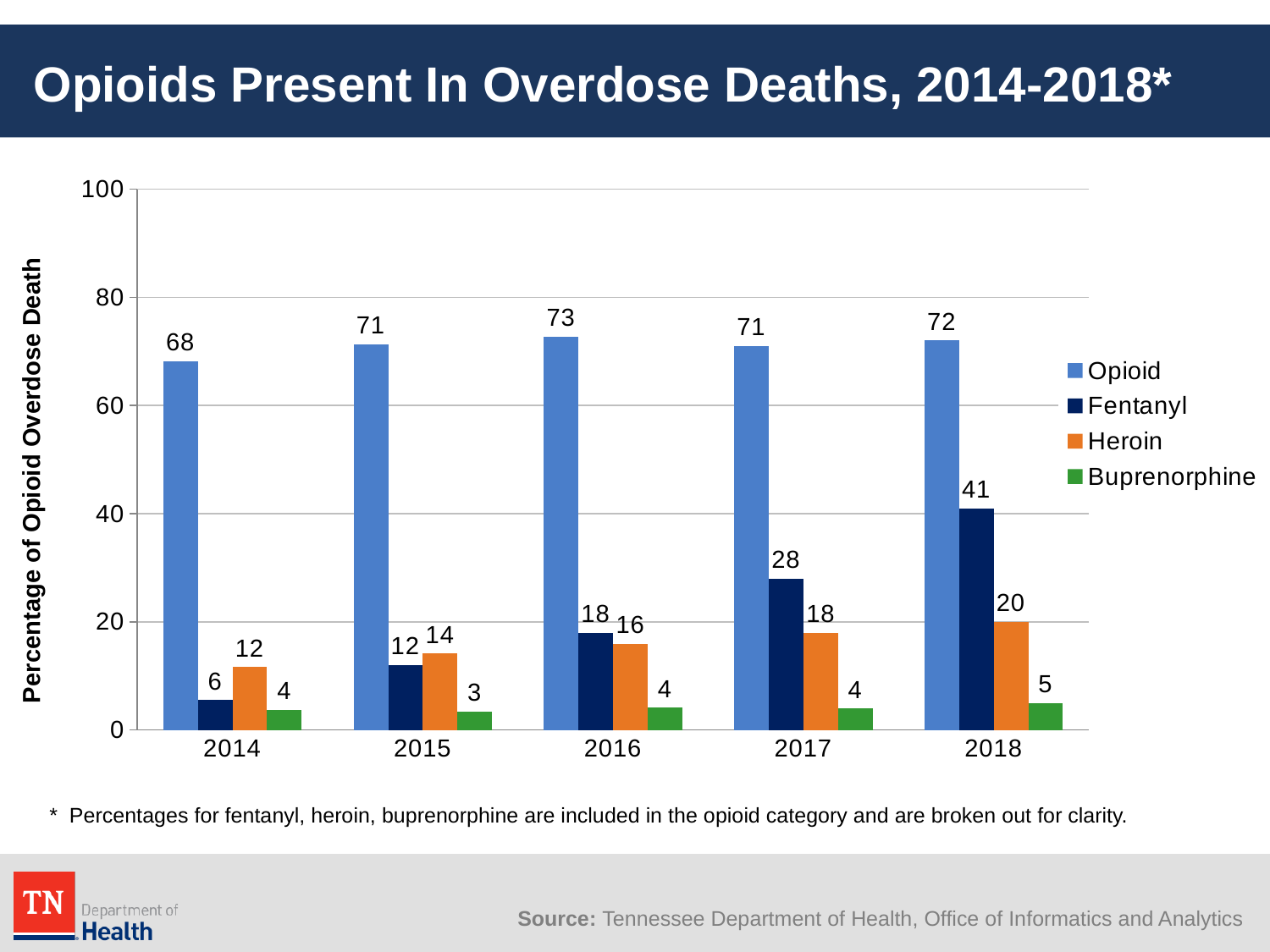
What kind of chart is shown on the slide? bar chart In which year is the Fentanyl value lowest? 2014 How many series does the legend list? 4 In which year is the Opioid value highest? 2016 What is the value for Fentanyl in 2018? 41 Does the Fentanyl value rise or fall from 2014 to 2018? rise Which is larger in 2016, Fentanyl or Heroin? Fentanyl Is the value for Fentanyl in 2018 greater or less than 40? greater What is the difference between the Fentanyl values in 2018 and 2017? 13 How many years are shown on the x axis? 5 What is the value for Opioid in 2014? 68 What is the value for Heroin in 2015? 14